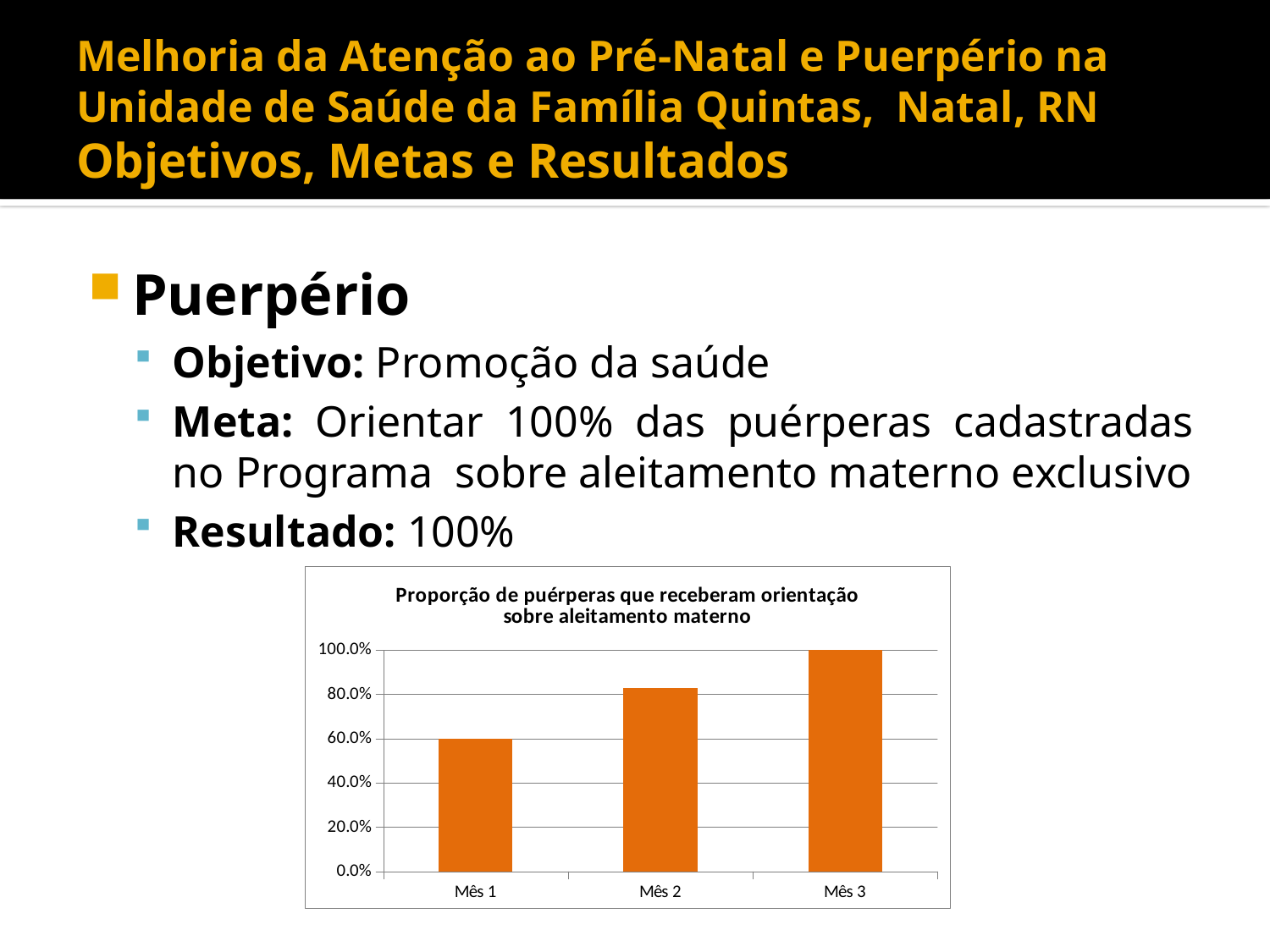
Is the value for Mês 2 greater or less than 80.0%? greater What is the title of the chart? Proporção de puérperas que receberam orientação sobre aleitamento materno Which month has the lowest value? Mês 1 What is the value for Mês 3? 100.0% Which is larger, the value for Mês 1 or the value for Mês 2? Mês 2 Is the value for Mês 2 greater or less than 100.0%? less What is the value for Mês 1? 60.0% How many categories are shown on the x axis of the chart? 3 What kind of chart is shown on the slide? bar chart Do the values rise or fall from Mês 1 to Mês 3? rise Which month has the highest value? Mês 3 What is the difference between the values for Mês 3 and Mês 1? 40.0%